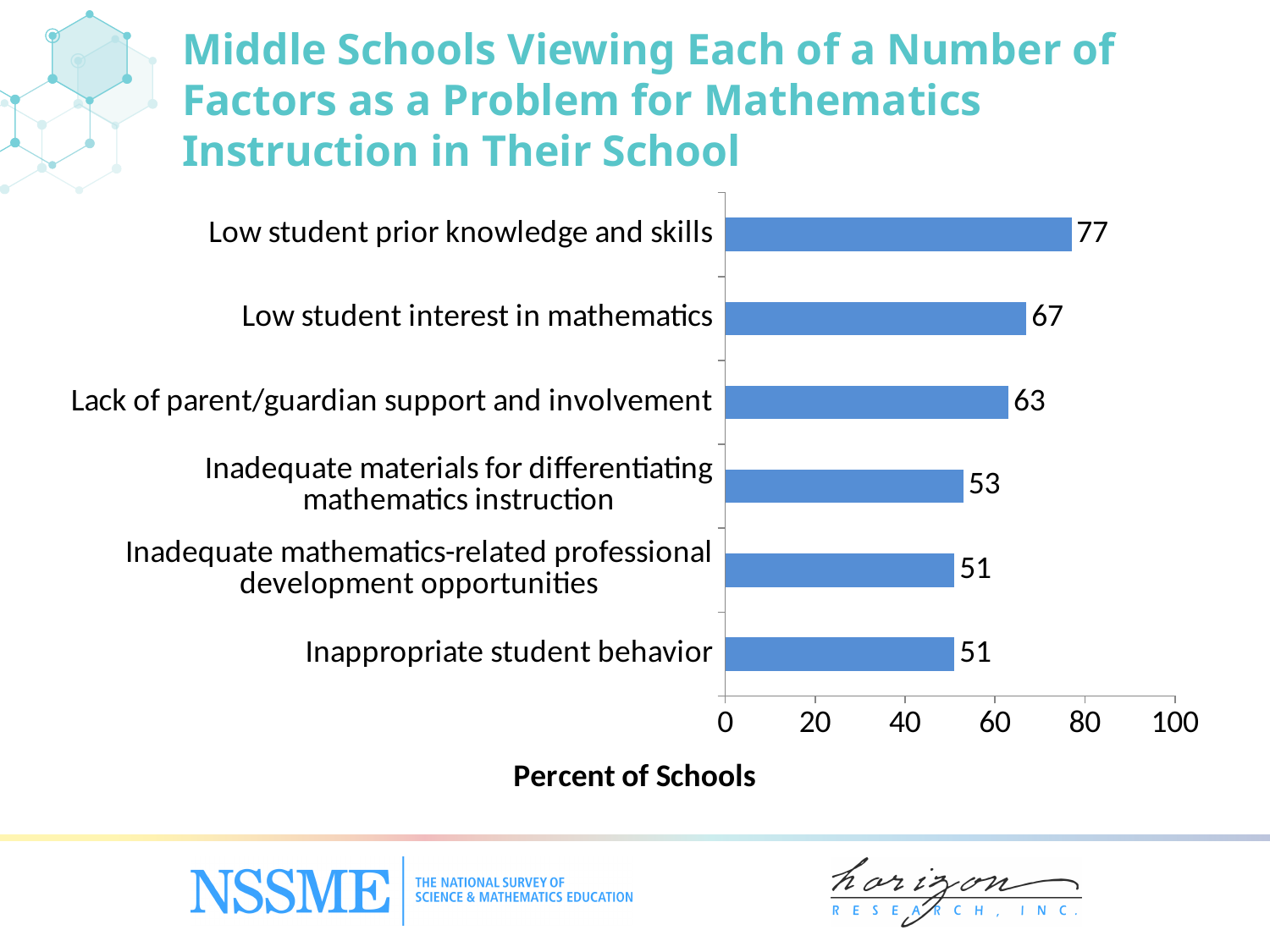
What kind of chart is shown on the slide? Bar chart What is the value for 'Lack of parent/guardian support and involvement'? 63 Is the value for 'Inappropriate student behavior' greater or less than 60? less What is the value for 'Low student interest in mathematics'? 67 What is the difference between the values for 'Lack of parent/guardian support and involvement' and 'Inappropriate student behavior'? 12 What is the label of the horizontal axis? Percent of Schools Which factor has the highest percent of schools viewing it as a problem? Low student prior knowledge and skills How many factors are shown in the chart? 6 Which is larger: the value for 'Low student interest in mathematics' or the value for 'Inadequate materials for differentiating mathematics instruction'? Low student interest in mathematics What is the difference between the values for 'Low student prior knowledge and skills' and 'Low student interest in mathematics'? 10 What percent of middle schools view low student prior knowledge and skills as a problem for mathematics instruction? 77 What is the value for 'Inadequate materials for differentiating mathematics instruction'? 53